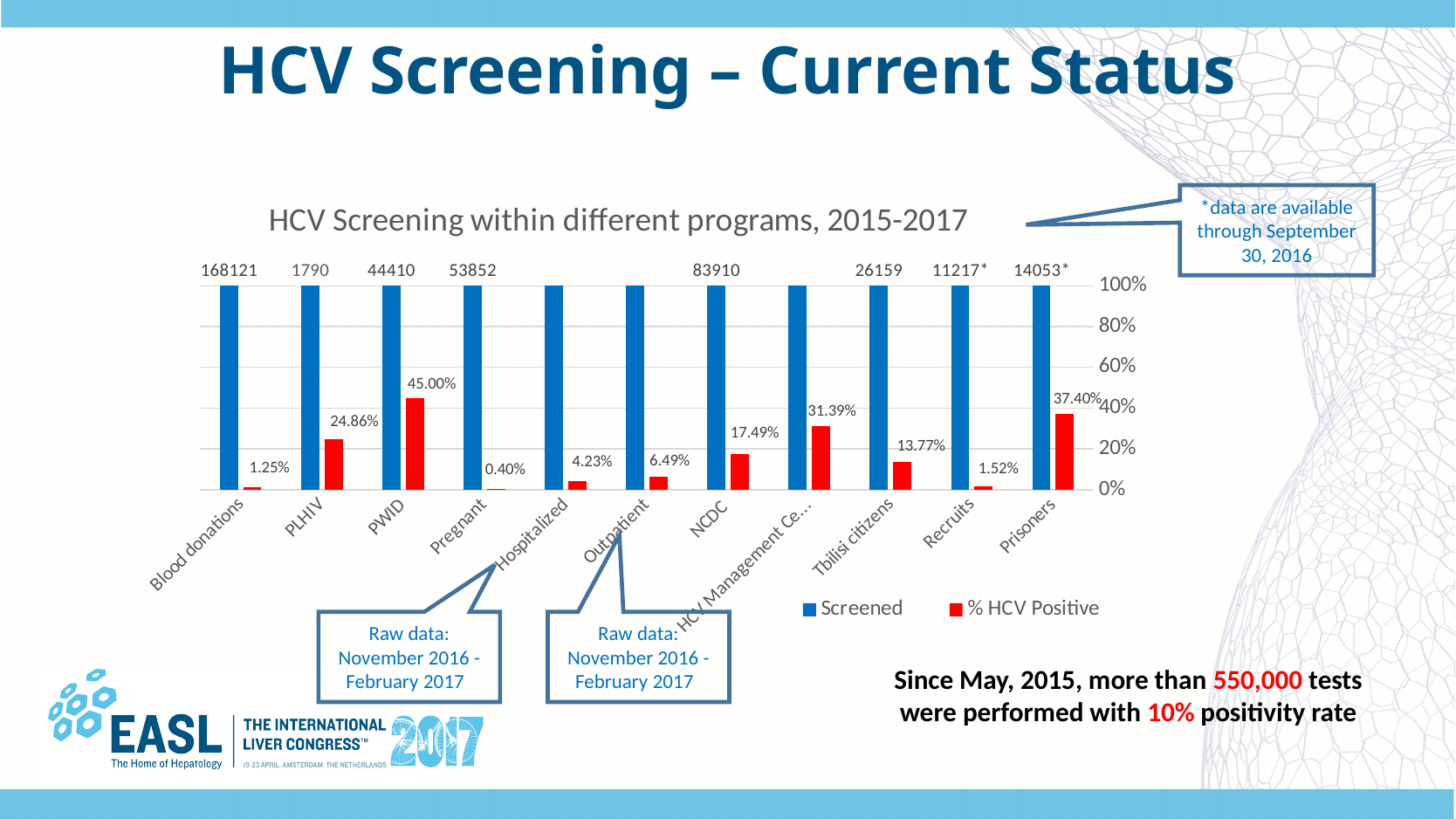
What is the title of the chart? HCV Screening within different programs, 2015-2017 What is the Screened data label for NCDC? 83910 Which program has the lowest % HCV Positive? Pregnant How many people were screened in the Blood donations program, according to the data label? 168121 Which program has the highest % HCV Positive? PWID Which has a higher % HCV Positive, PLHIV or Tbilisi citizens? PLHIV How many programs (categories) are shown on the x axis? 11 What is the difference in % HCV Positive between PWID and Prisoners? 7.60% What is the % HCV Positive value for PWID? 45.00% How many series does the legend list? 2 What is the % HCV Positive value for Prisoners? 37.40% What type of chart is shown? Bar chart